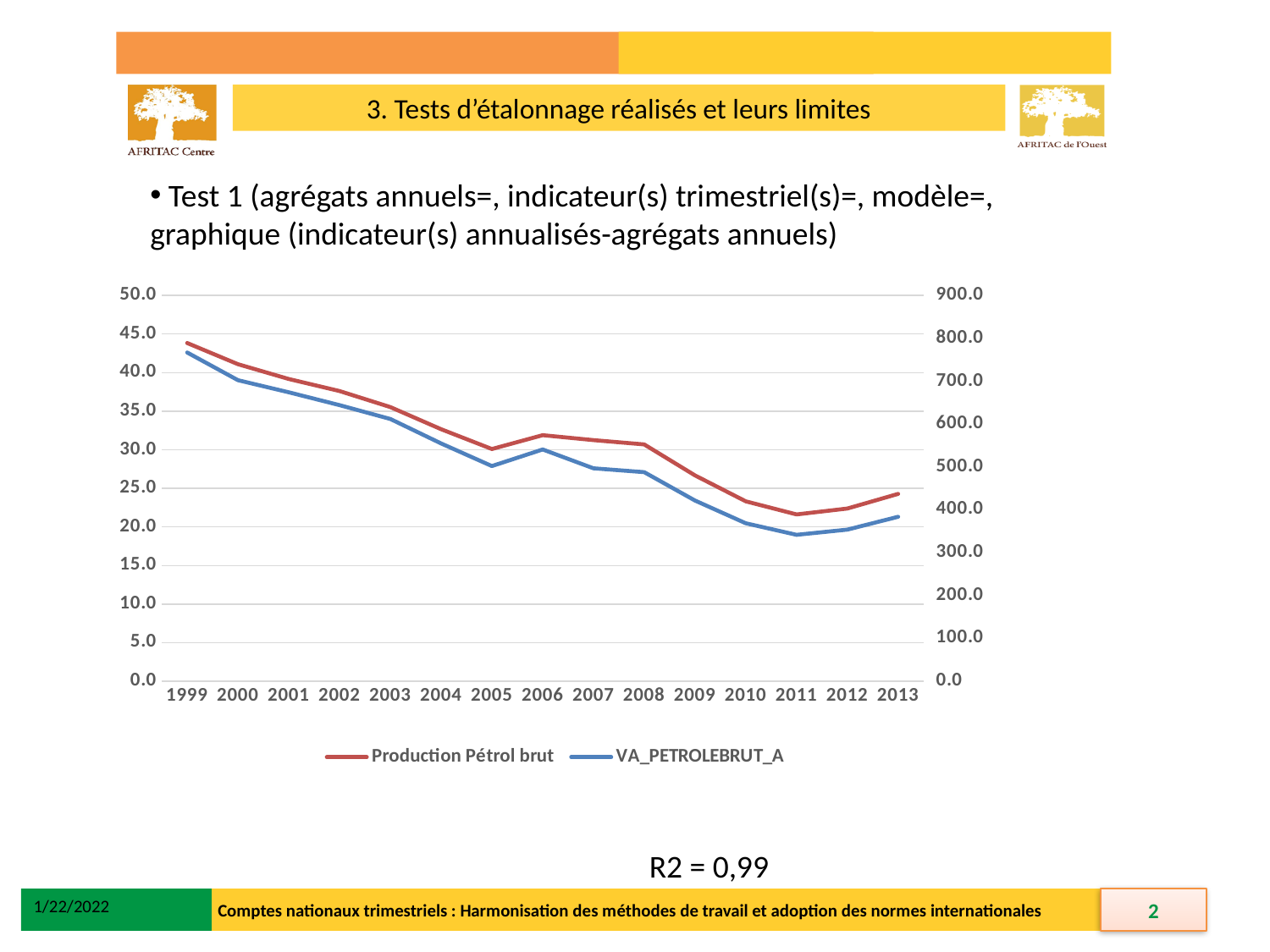
How many series does the chart legend list? 2 Overall, do the plotted series rise or fall from 1999 to 2013? fall What are the two series names shown in the chart legend? Production Pétrol brut and VA_PETROLEBRUT_A In which year does the Production Pétrol brut series reach its lowest point? 2011 How many years are plotted along the x axis of the chart? 15 What kind of chart is shown on the slide? line chart For the Production Pétrol brut series, is the value in 2006 higher or lower than in 2005? higher In which year does the VA_PETROLEBRUT_A series reach its highest point? 1999 In which year does the VA_PETROLEBRUT_A series reach its lowest point? 2011 For the VA_PETROLEBRUT_A series, is the value in 2013 higher or lower than in 2011? higher What colour is the line for the Production Pétrol brut series? red